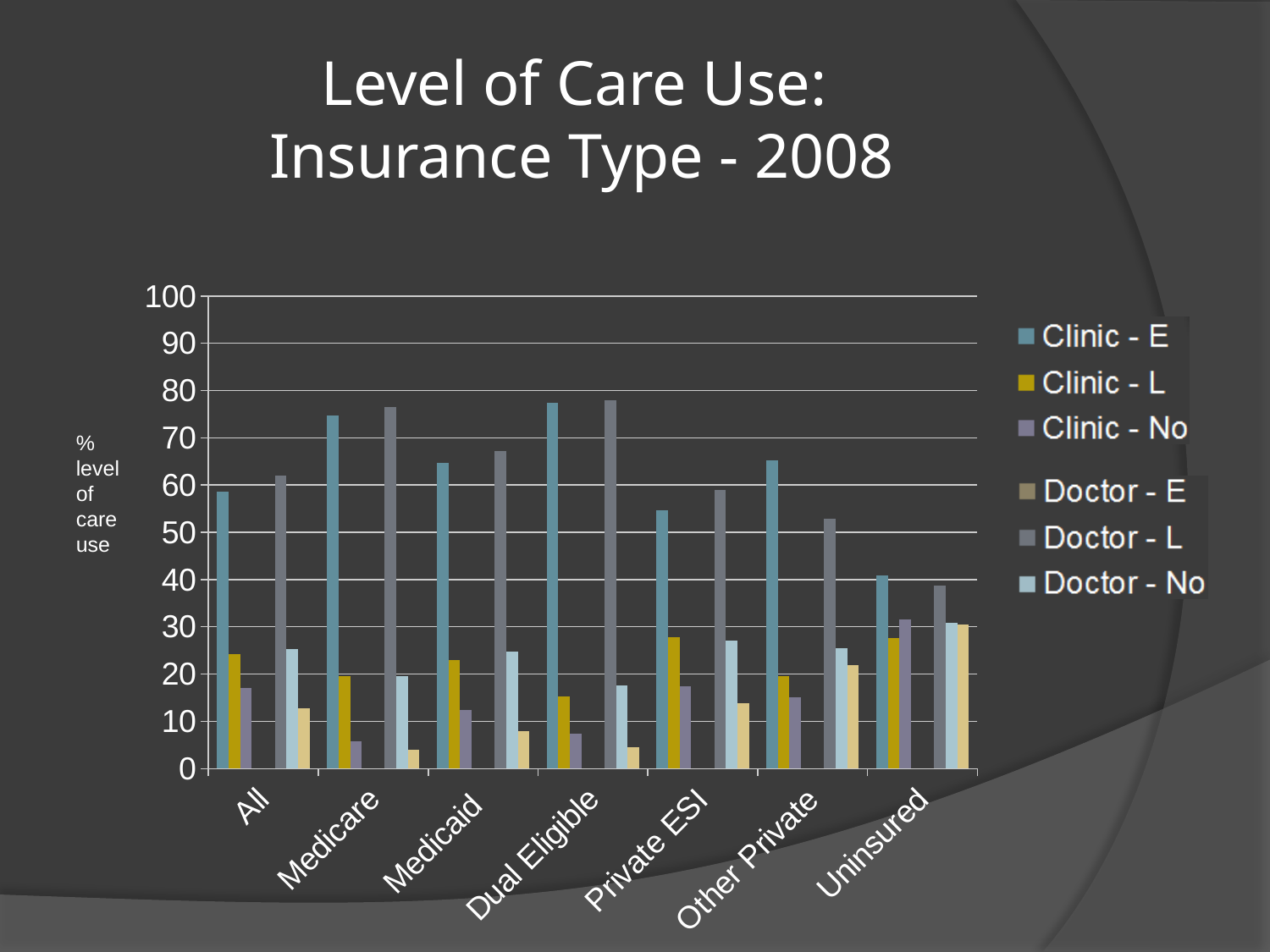
Is the value for Doctor - L in the Dual Eligible category greater or less than 70? greater What is the title of the chart on the slide? Level of Care Use: Insurance Type - 2008 Is the value for Doctor - E in the Medicare category greater or less than 10? less Which category has the highest value for Doctor - E? Uninsured What kind of chart is shown on the slide? Bar chart In the Private ESI category, which is larger: Clinic - E or Doctor - L? Doctor - L How many series does the legend list? 6 Which category has the highest value for Clinic - No? Uninsured Is the value for Clinic - E in the Medicare category greater or less than 70? greater Which category has the lowest value for Clinic - E? Uninsured How many insurance type categories are shown on the x axis? 7